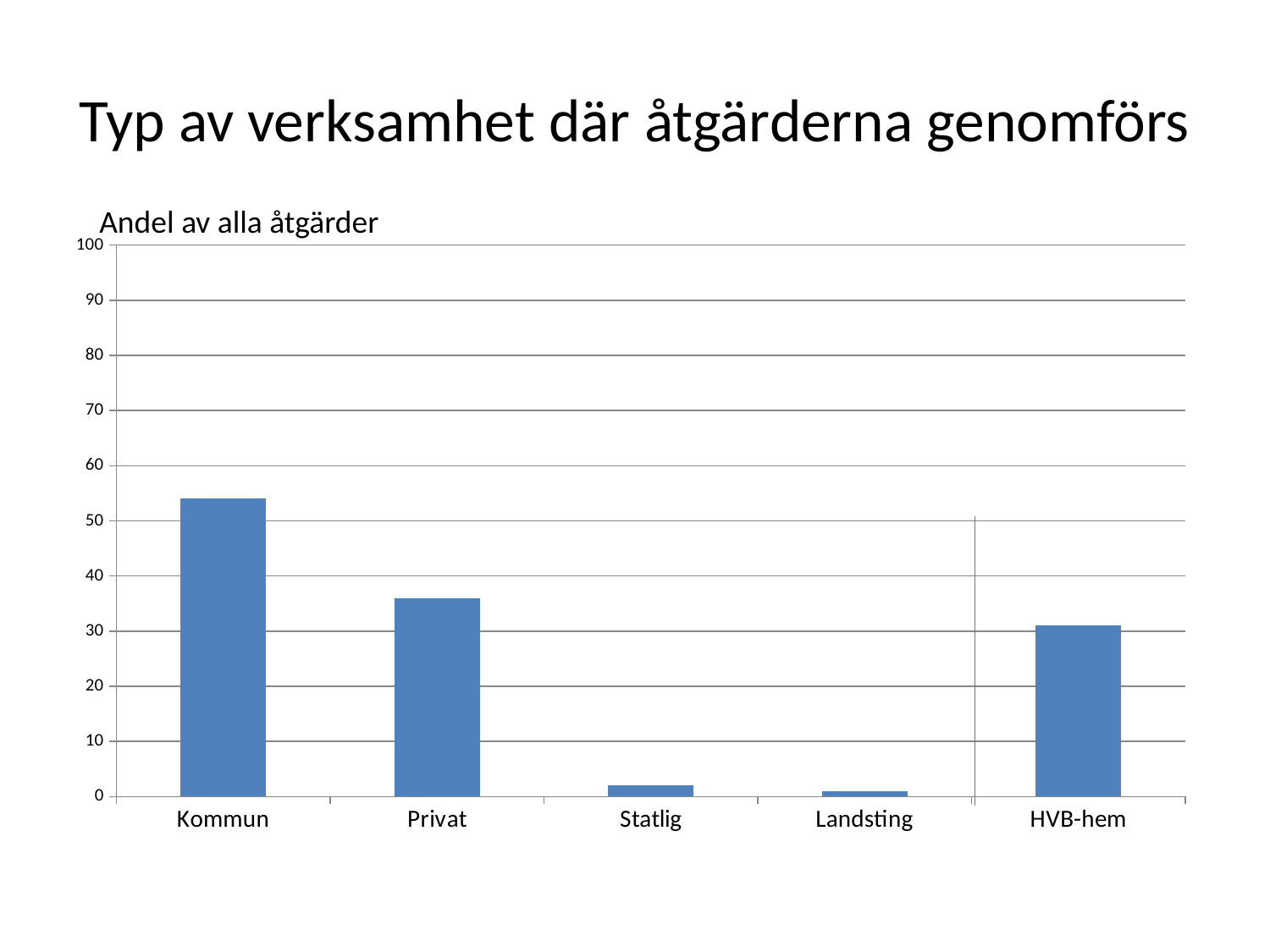
Which category has the highest value in the chart? Kommun Which is larger, the value for Privat or the value for HVB-hem? Privat What is the title of the chart on the slide? Andel av alla åtgärder Is the value for Privat greater or less than 40? less How many categories are shown on the x axis of the chart? 5 Which is larger, the value for Kommun or the value for Privat? Kommun What kind of chart is shown on the slide? bar chart Is the value for HVB-hem greater or less than 40? less Is the value for Kommun greater or less than 50? greater